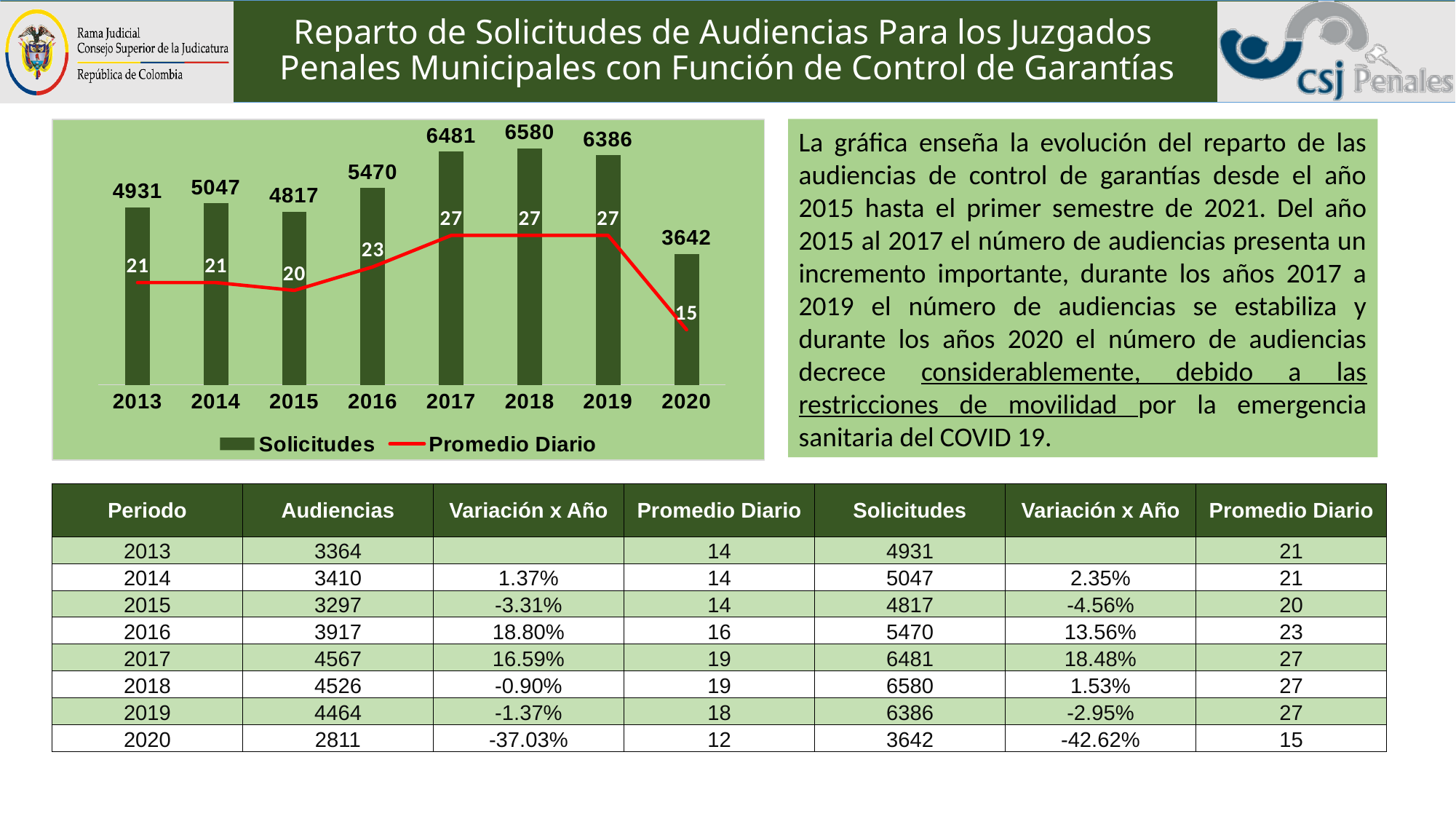
What is the value of Solicitudes for 2017? 6481 Which year has the lowest Solicitudes value? 2020 How many years are shown on the x axis of the chart? 8 What colour is the Promedio Diario line in the chart? Red How many series does the chart legend list? 2 Which is larger, the Solicitudes value for 2014 or for 2015? 2014 What is the lowest Promedio Diario value shown on the chart? 15 What is the difference between the Solicitudes values for 2018 and 2020? 2938 Which year has the highest Solicitudes value? 2018 What kind of chart is used for the Solicitudes series? Bar chart What is the Promedio Diario value for 2016? 23 Does the Promedio Diario line rise or fall from 2019 to 2020? Fall